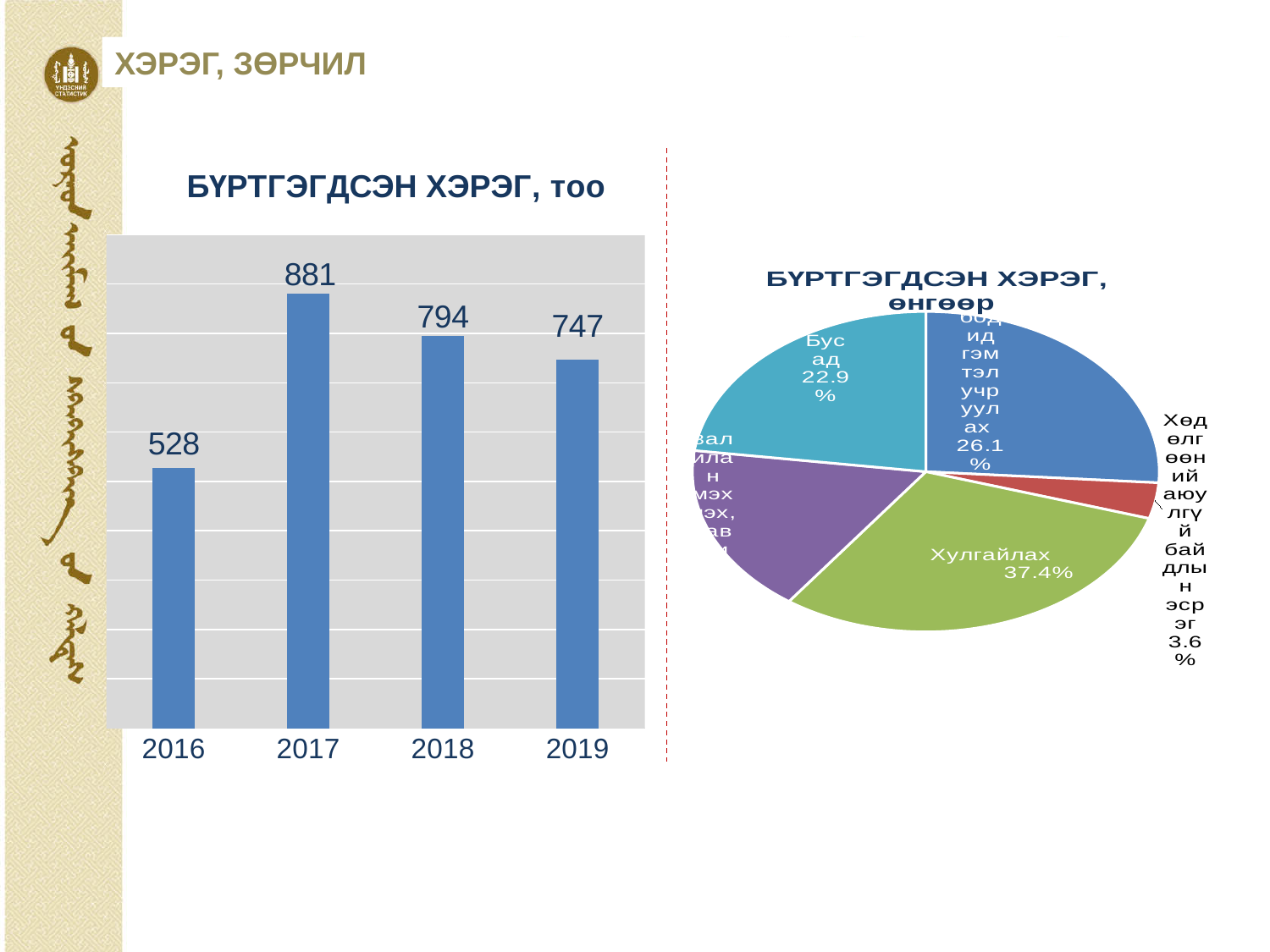
In the pie chart titled 'БҮРТГЭГДСЭН ХЭРЭГ, өнгөөр', what share does 'Хулгайлах' have? 37.4% In the bar chart titled 'БҮРТГЭГДСЭН ХЭРЭГ, тоо', what is the value for 2016? 528 In the bar chart titled 'БҮРТГЭГДСЭН ХЭРЭГ, тоо', how many years are shown? 4 In the bar chart titled 'БҮРТГЭГДСЭН ХЭРЭГ, тоо', what is the difference between the values for 2017 and 2016? 353 In the bar chart titled 'БҮРТГЭГДСЭН ХЭРЭГ, тоо', do the values rise or fall from 2017 to 2019? fall In the bar chart titled 'БҮРТГЭГДСЭН ХЭРЭГ, тоо', which year has the highest value? 2017 In the bar chart titled 'БҮРТГЭГДСЭН ХЭРЭГ, тоо', what is the value for 2017? 881 In the bar chart titled 'БҮРТГЭГДСЭН ХЭРЭГ, тоо', what is the value for 2019? 747 What kind of chart is the chart on the left of the slide? bar chart In the bar chart titled 'БҮРТГЭГДСЭН ХЭРЭГ, тоо', which is larger, the value for 2018 or the value for 2019? 2018 In the pie chart titled 'БҮРТГЭГДСЭН ХЭРЭГ, өнгөөр', what share does 'Бусад' have? 22.9% In the bar chart titled 'БҮРТГЭГДСЭН ХЭРЭГ, тоо', which year has the lowest value? 2016